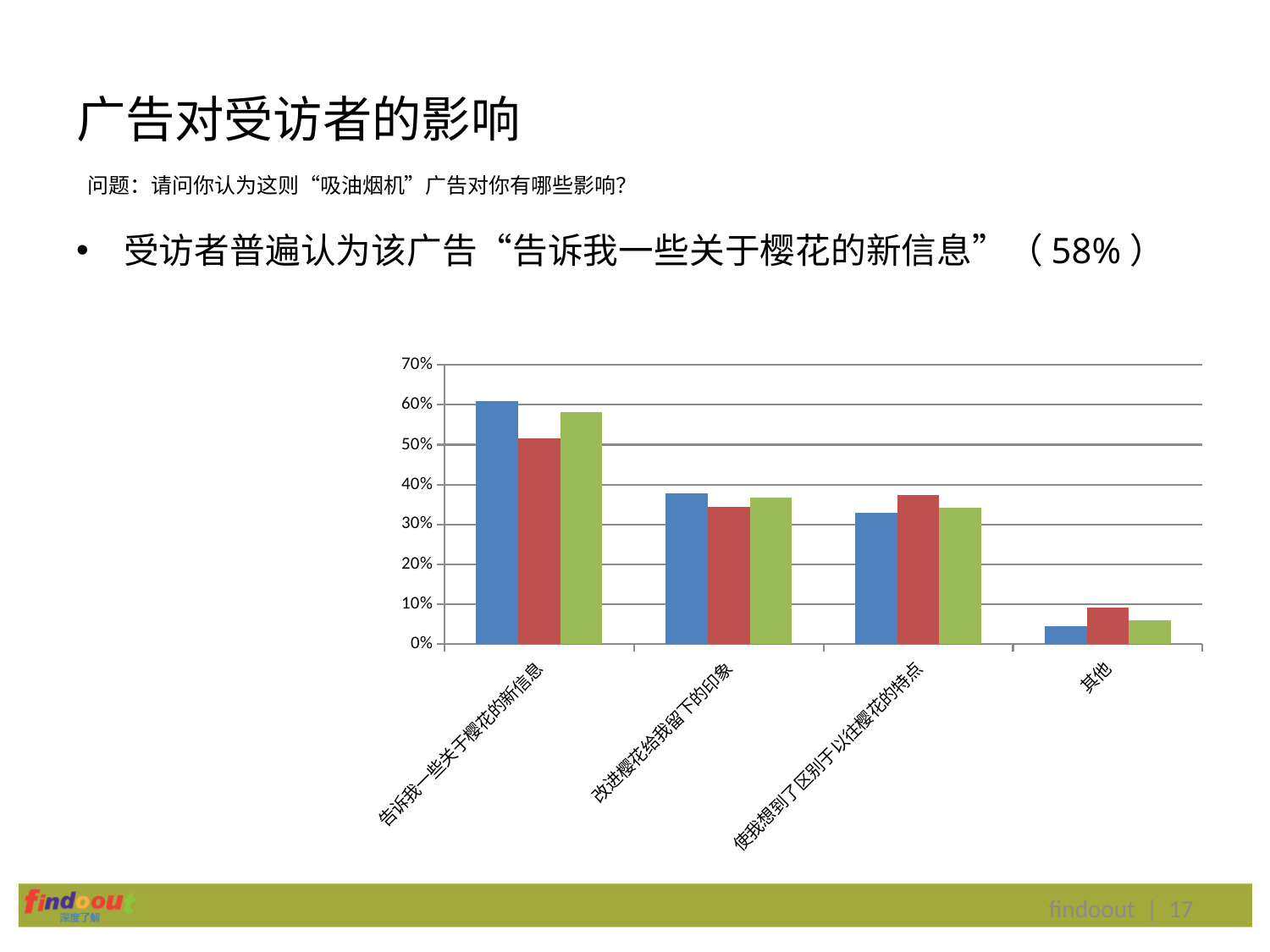
Which category has the tallest bars in the chart? 告诉我一些关于樱花的新信息 Which category has the shortest bars in the chart? 其他 Within the category 其他, which is larger, the red bar or the blue bar? the red bar Is the red bar for 使我想到了区别于以往樱花的特点 greater or less than 30%? greater Is the red bar for 告诉我一些关于樱花的新信息 greater or less than 60%? less Within the category 告诉我一些关于樱花的新信息, which is larger, the blue bar or the red bar? the blue bar Is the blue bar for 改进樱花给我留下的印象 greater or less than 40%? less How many bars are plotted for each category in the chart? 3 What kind of chart is shown on the slide? bar chart How many categories are shown on the x axis of the chart? 4